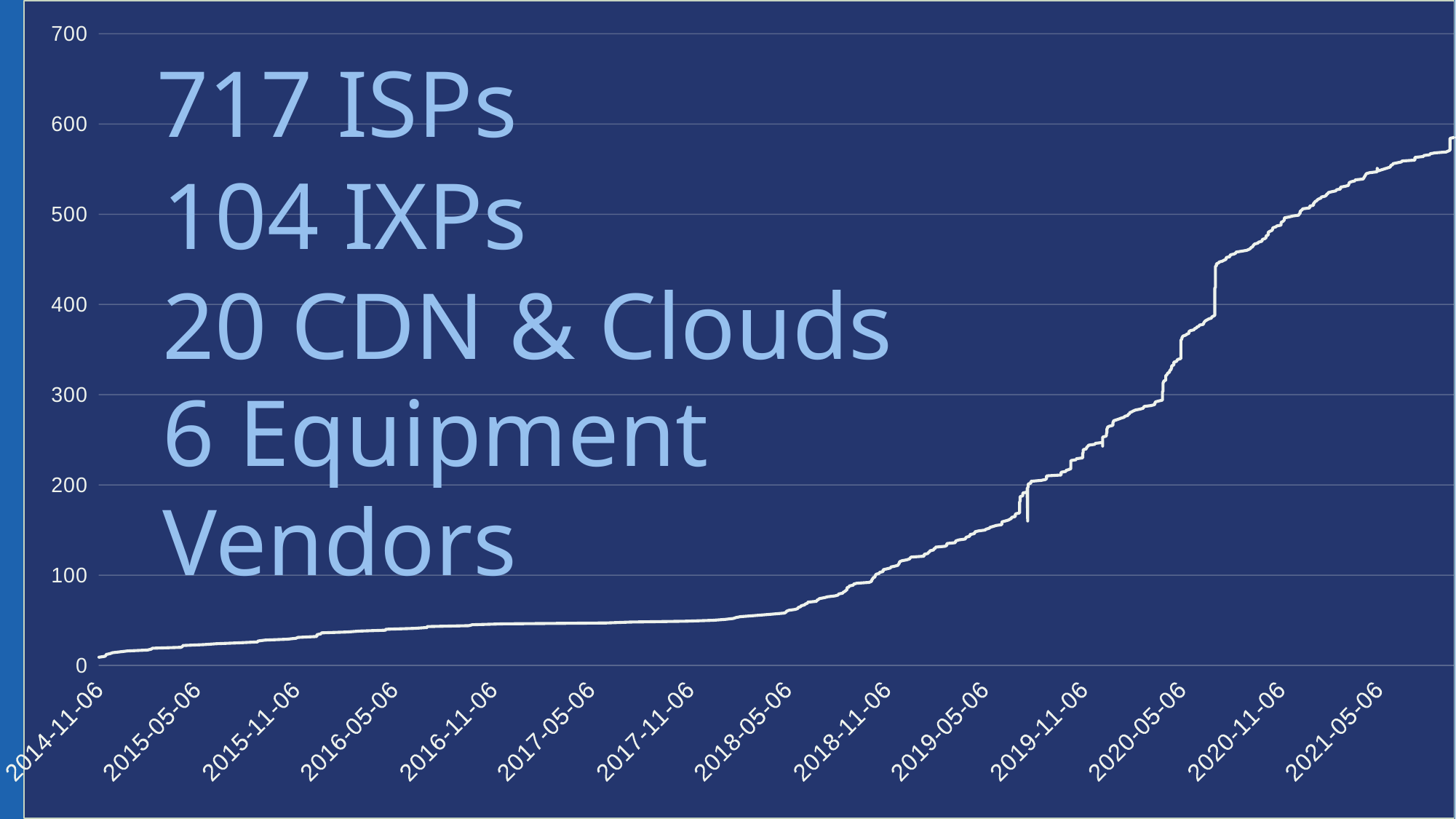
Is the value at 2020-11-06 greater or less than 400? greater Is the value at 2019-05-06 greater or less than 200? less How many ISPs does the text on the slide mention? 717 Is the value at 2017-05-06 greater or less than 100? less Does the plotted line generally rise or fall from 2014-11-06 to 2021-05-06? rise What is the highest value shown on the y axis? 700 At which x-axis date is the plotted value lowest? 2014-11-06 What kind of chart is shown on the slide? line chart How many date labels are shown on the x axis? 14